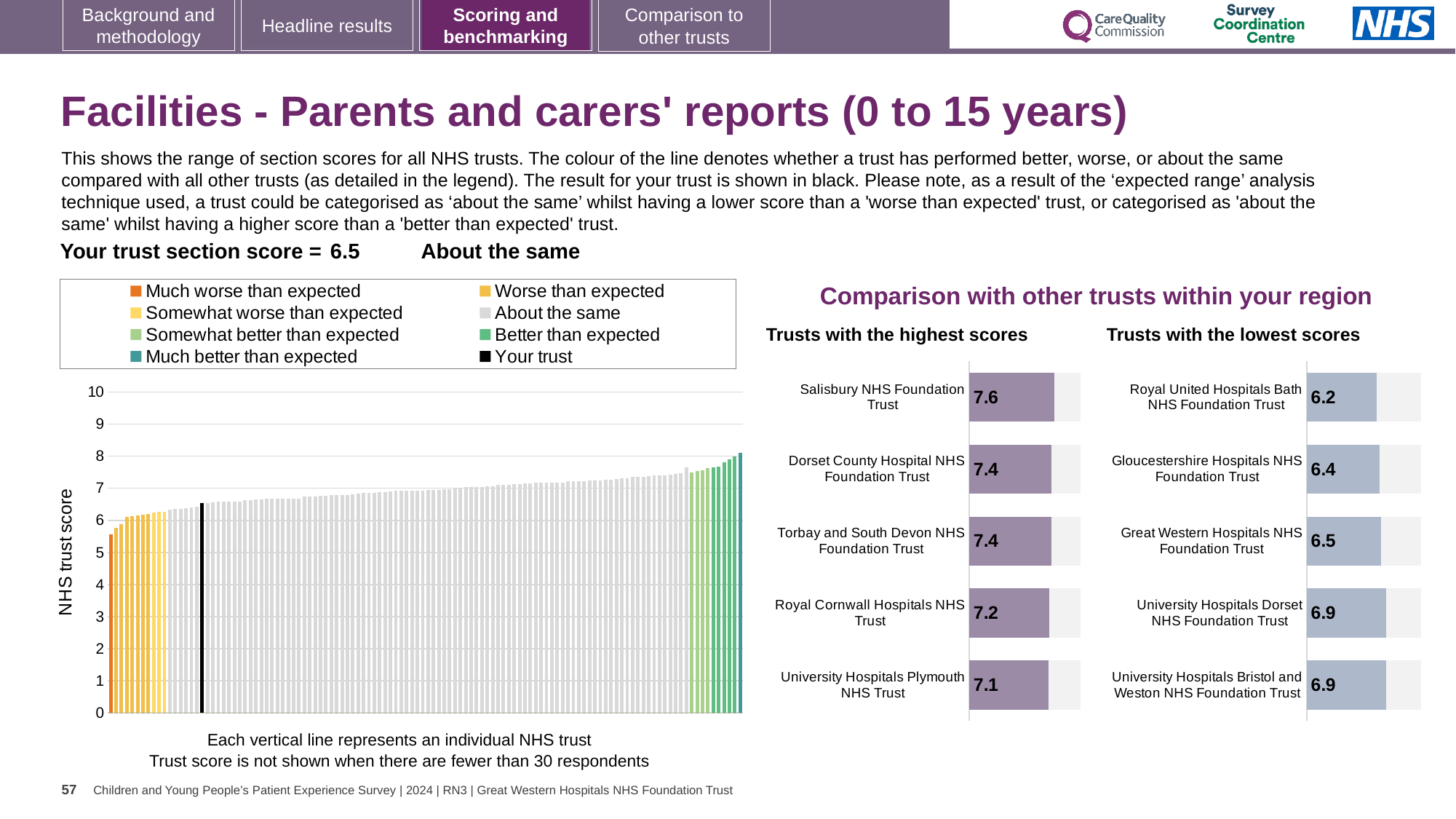
How many trusts are listed in the 'Trusts with the lowest scores' chart? 5 In the 'Trusts with the highest scores' chart, what is the difference between the scores of Salisbury NHS Foundation Trust and University Hospitals Plymouth NHS Trust? 0.5 In the large chart on the left showing all NHS trusts, do the values rise or fall from left to right? rise In the 'Trusts with the highest scores' chart, which trust has the highest score? Salisbury NHS Foundation Trust In the 'Trusts with the lowest scores' chart, what is the score for Royal United Hospitals Bath NHS Foundation Trust? 6.2 In the 'Trusts with the highest scores' chart, what is the score for Salisbury NHS Foundation Trust? 7.6 Which has the higher score: Dorset County Hospital NHS Foundation Trust in the 'highest scores' chart or Gloucestershire Hospitals NHS Foundation Trust in the 'lowest scores' chart? Dorset County Hospital NHS Foundation Trust In the 'Trusts with the lowest scores' chart, which trust has the lowest score? Royal United Hospitals Bath NHS Foundation Trust In the 'Trusts with the lowest scores' chart, what is the difference between the scores of Great Western Hospitals NHS Foundation Trust and Royal United Hospitals Bath NHS Foundation Trust? 0.3 In the large chart on the left showing all NHS trusts, is the value for the black bar (your trust) greater or less than 7? less In the 'Trusts with the highest scores' chart, which trust has the lowest score? University Hospitals Plymouth NHS Trust What type of chart is the large chart on the left showing all NHS trusts? bar chart